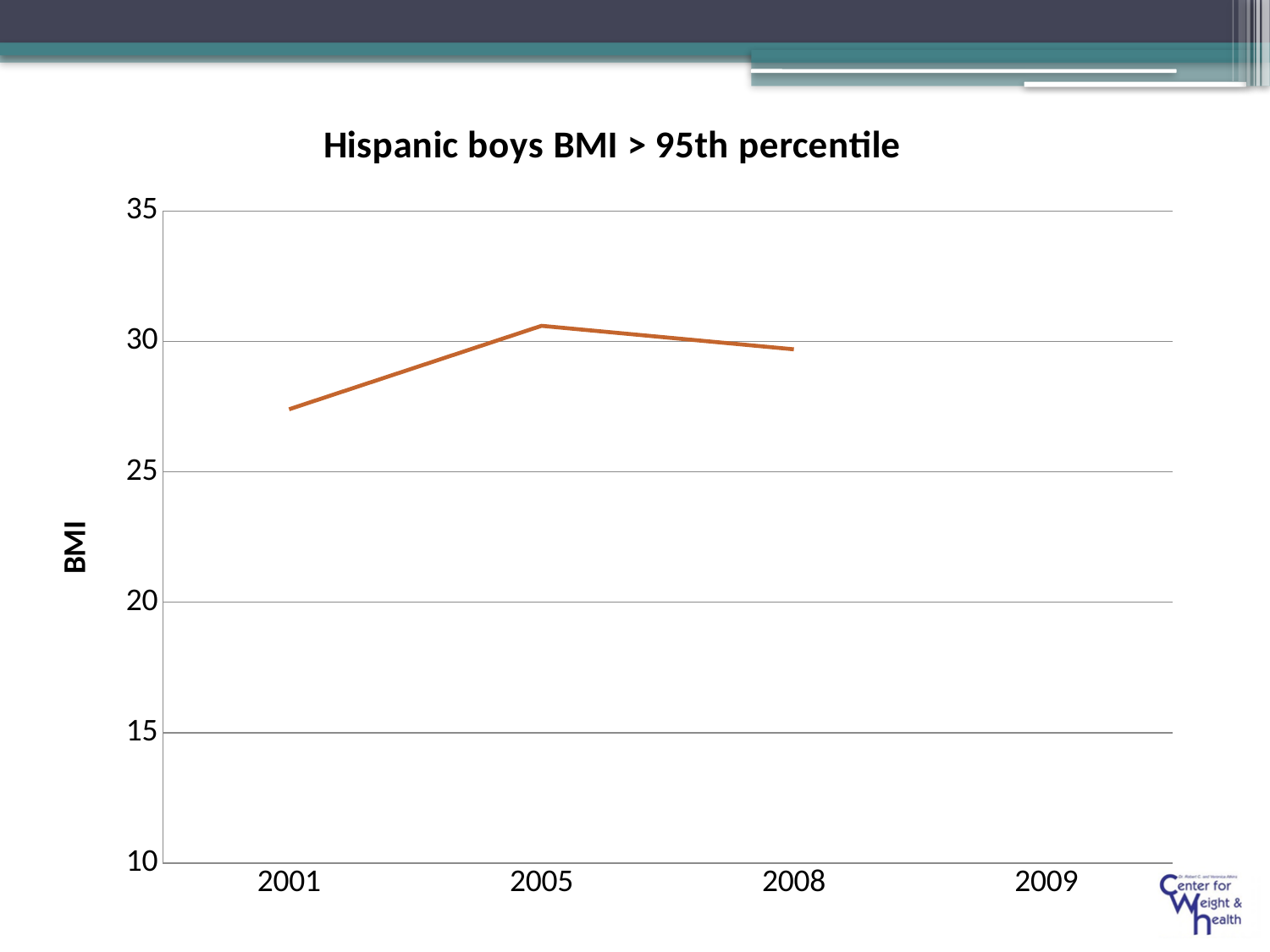
Is the BMI value for 2005 greater or less than 25? greater Which year has the highest BMI value on the chart? 2005 What is the label on the y axis of the chart? BMI Is the BMI value for 2001 greater or less than 30? less Does the BMI value rise or fall from 2001 to 2005? rise What kind of chart is shown on the slide? line chart Is the BMI value for 2001 greater or less than 25? greater Does the BMI value rise or fall from 2005 to 2008? fall How many years are labelled on the x axis? 4 Which year has a larger BMI value, 2001 or 2005? 2005 What is the title of the chart? Hispanic boys BMI > 95th percentile Which year has the lowest BMI value on the chart? 2001